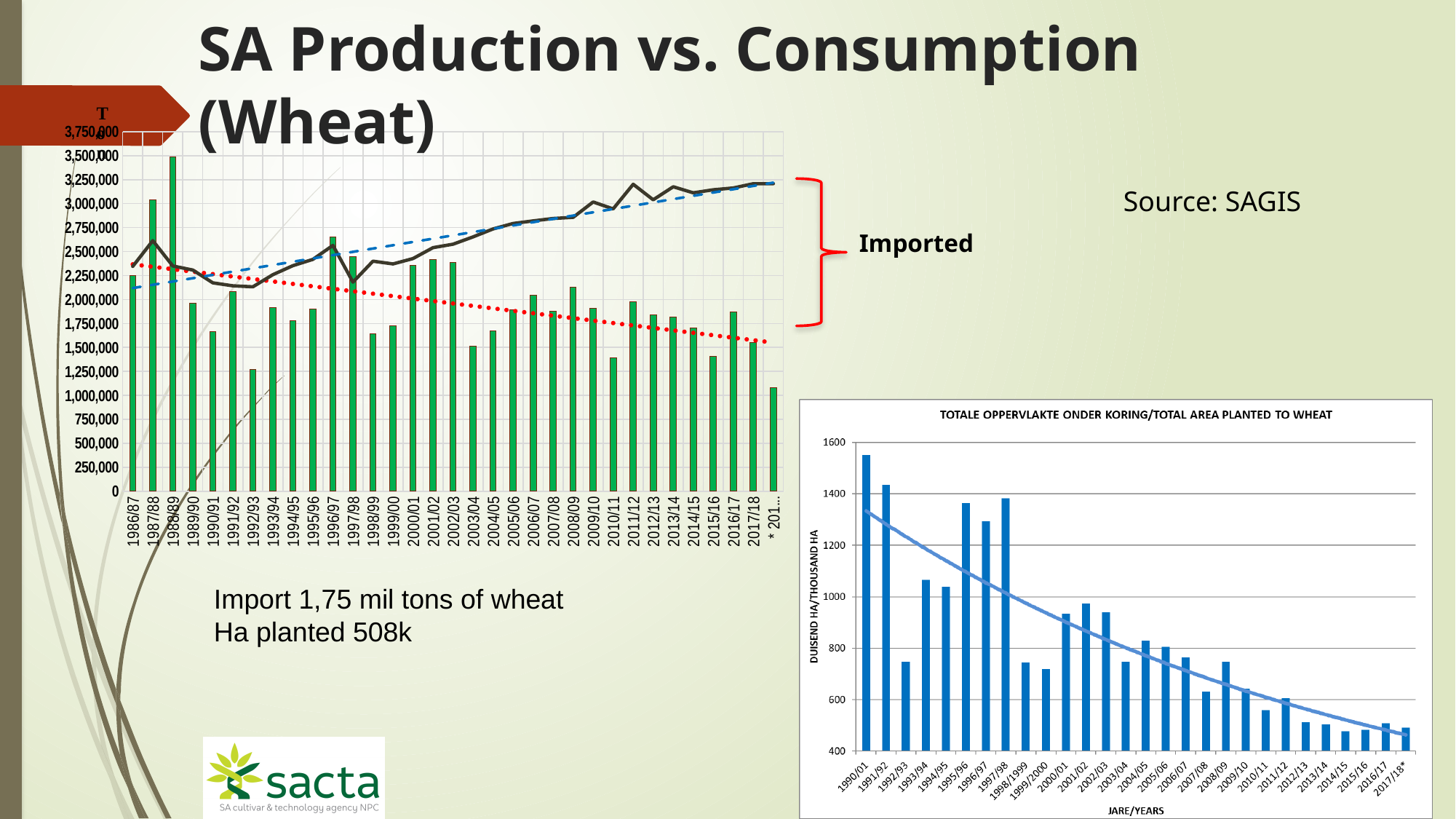
In the bottom-right chart titled 'TOTAL AREA PLANTED TO WHEAT', how many years are shown on the x axis? 28 In the bottom-right chart titled 'TOTAL AREA PLANTED TO WHEAT', which is larger, the value for 1990/91 or the value for 1991/92? 1990/91 In the bottom-right chart titled 'TOTAL AREA PLANTED TO WHEAT', is the value for 1992/93 greater or less than 800? less In the bottom-right chart titled 'TOTAL AREA PLANTED TO WHEAT', do the values generally rise or fall from 1990/91 to 2017/18? fall What kind of chart is the bottom-right chart titled 'TOTAL AREA PLANTED TO WHEAT'? bar chart In the top-left chart with green bars, which year has the tallest bar? 1988/89 In the top-left chart with green bars, is the bar for 1988/89 greater or less than 3,250,000? greater In the bottom-right chart titled 'TOTAL AREA PLANTED TO WHEAT', which year has the highest bar? 1990/01 What is the y-axis label of the bottom-right chart titled 'TOTAL AREA PLANTED TO WHEAT'? DUISEND HA/THOUSAND HA In the bottom-right chart titled 'TOTAL AREA PLANTED TO WHEAT', is the value for 1990/91 greater or less than 1400? greater